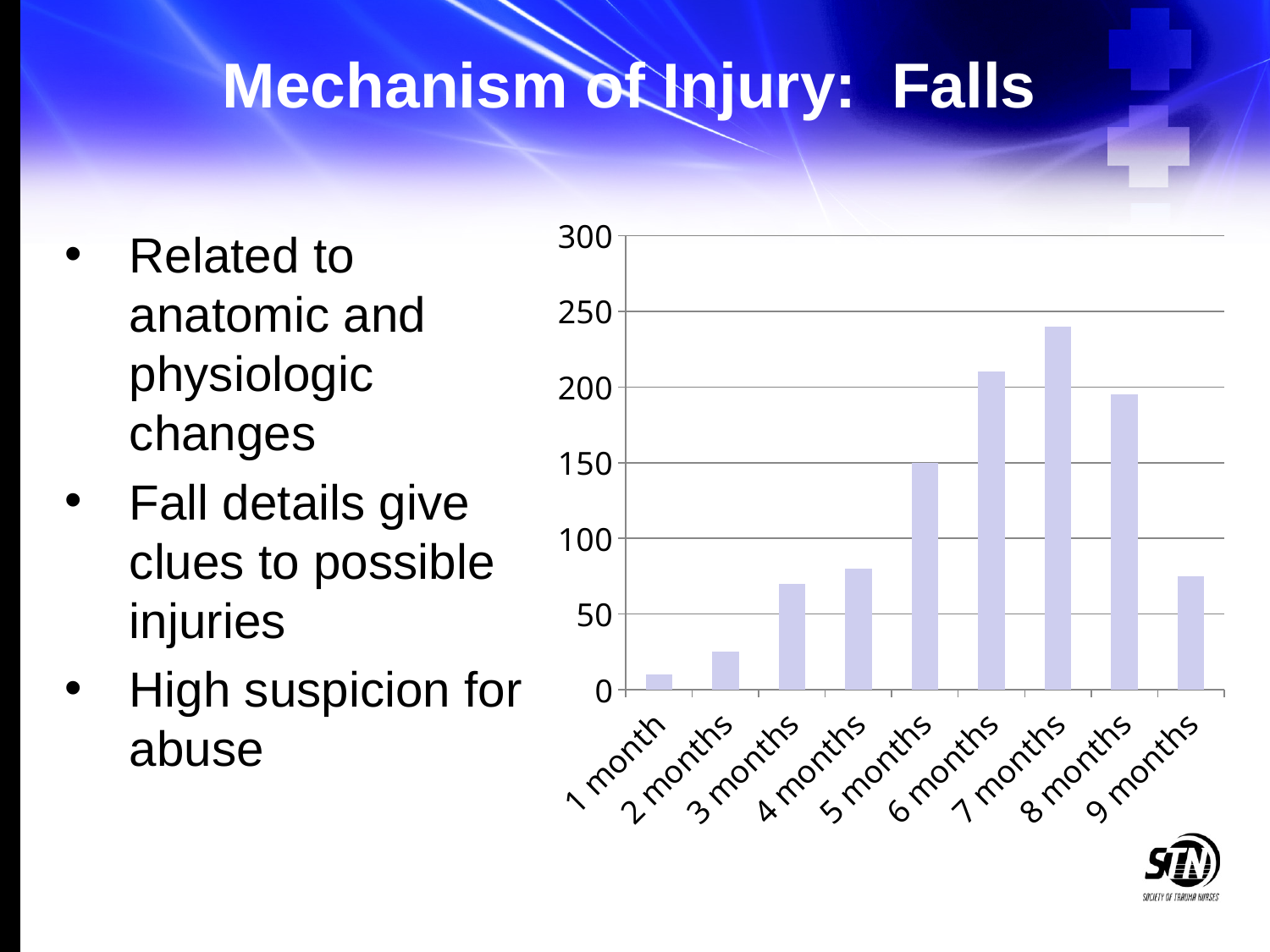
Is the value for 2 months greater or less than 50? less What is the highest value shown on the chart's vertical axis? 300 Is the value for 6 months greater or less than 200? greater Which is larger, the value for 6 months or the value for 8 months? 6 months Do the values rise or fall from 1 month to 7 months? rise What kind of chart is shown on the slide? bar chart Is the value for 7 months greater or less than 200? greater Which category has the lowest bar in the chart? 1 month What is the value for 5 months in the chart? 150 How many categories are shown on the x axis of the chart? 9 Which category has the highest bar in the chart? 7 months